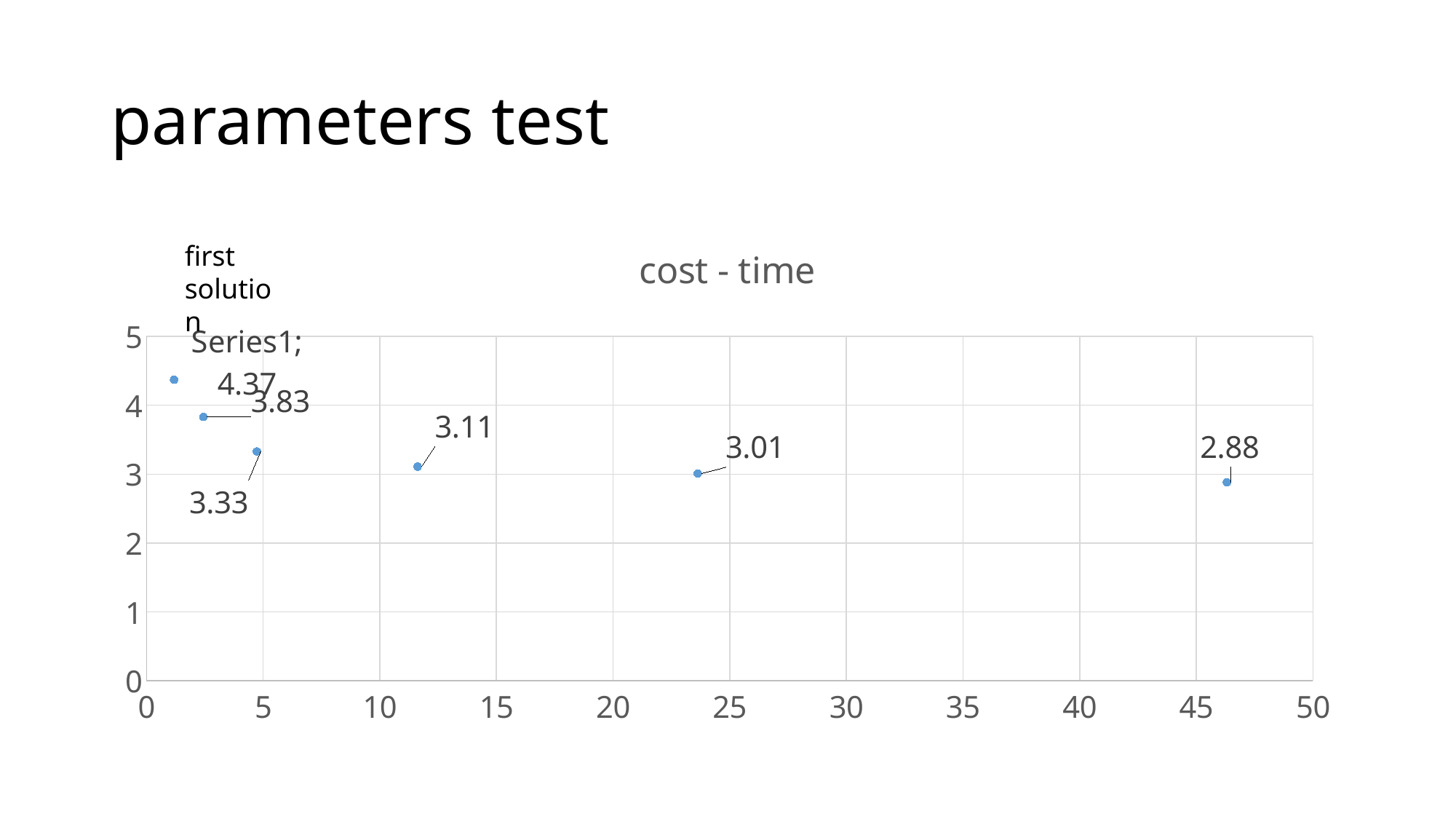
What is the lowest labelled value in the chart? 2.88 What is the highest labelled value in the chart? 4.37 What is the difference between the highest labelled value (4.37) and the lowest labelled value (2.88)? 1.49 How many data points are plotted in the chart? 6 What is the labelled value of the point plotted near x = 12? 3.11 Which point is annotated with the text 'first solution'? the point labelled 4.37 What is the labelled value of the point plotted near x = 24? 3.01 What kind of chart is shown on the slide? scatter chart Is the value of the point plotted furthest to the right (near x = 46) greater or less than 3? less Which is larger: the point labelled 3.83 or the point labelled 3.11? 3.83 Do the plotted values rise or fall as the x value increases? fall What is the title of the chart? cost - time